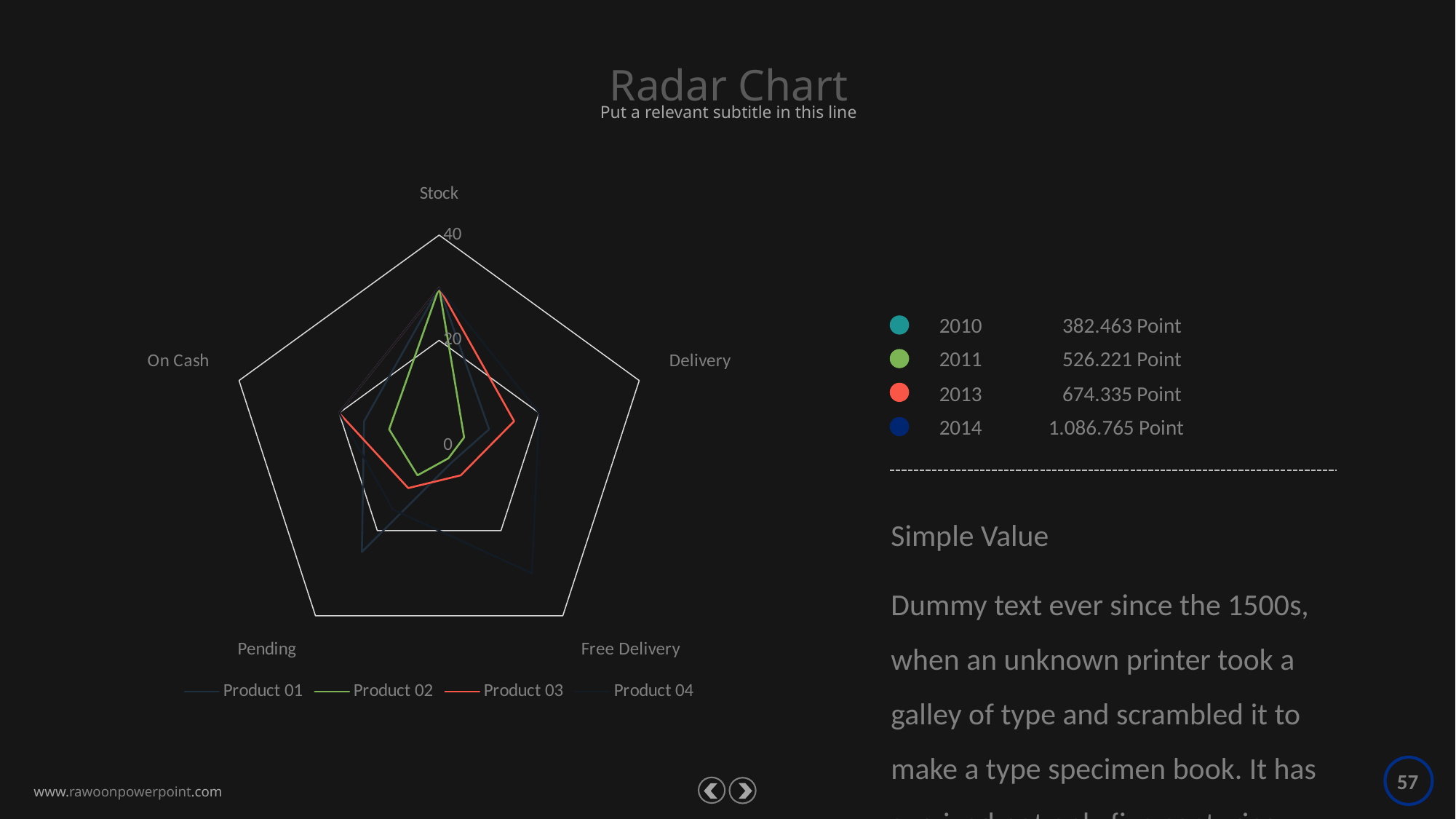
For Delivery, which has the larger value: Product 02 or Product 03? Product 03 What is the title of the chart on the slide? Radar Chart What kind of chart is shown on the slide? Radar chart What is the highest value shown on the radar chart's axis scale? 40 Is the value of Product 03 for Stock greater or less than 20? greater How many series does the chart legend list? 4 Is the value of Product 03 for Pending greater or less than 20? less For which category does Product 02 have its highest value? Stock Is the value of Product 02 for Stock greater or less than 20? greater How many categories (axes) does the radar chart have? 5 For which category does Product 03 have its highest value? Stock